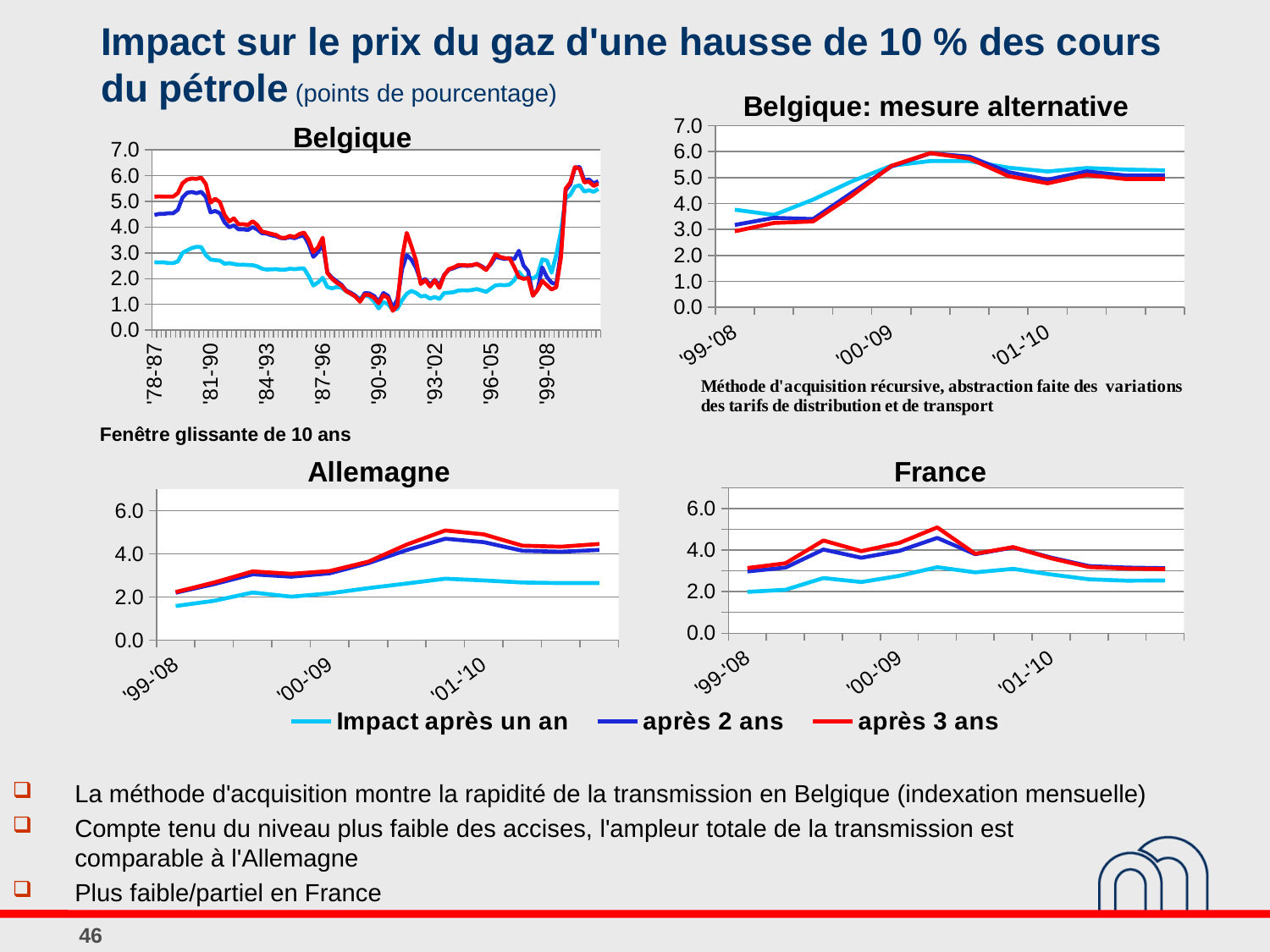
How many series does the shared legend below the 'Allemagne' and 'France' charts list? 3 In the 'Belgique' chart, is the value of 'Impact après un an' at '78-'87 greater or less than 2.0? greater In the 'Belgique: mesure alternative' chart, is the peak value of 'après 3 ans' greater or less than 5.0? greater In the 'Belgique: mesure alternative' chart, does the 'après 3 ans' series rise or fall from '99-'08 to '00-'09? rise What is the title of the chart in the top right of the slide? Belgique: mesure alternative In the 'Belgique: mesure alternative' chart, which series has the highest value at '99-'08? Impact après un an In the 'France' chart, is the peak value of 'après 3 ans' greater or less than 4.0? greater What kind of chart is the 'Allemagne' chart? line chart How many charts are shown on the slide? 4 In the 'Belgique' chart, how many labels are shown on the x axis? 8 In the 'Allemagne' chart, which is larger at '99-'08: 'après 3 ans' or 'Impact après un an'? après 3 ans